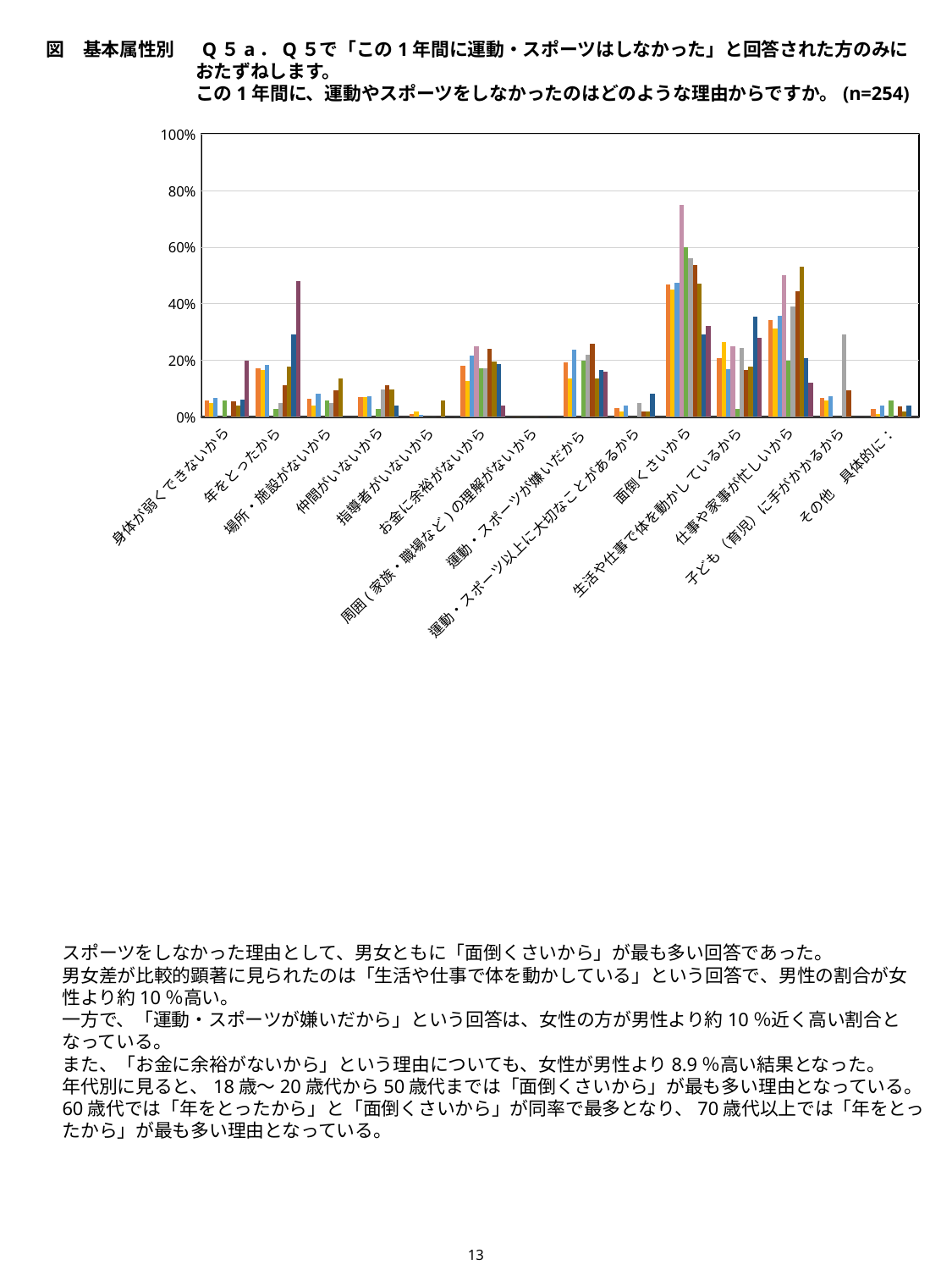
Is the tallest bar in the 面倒くさいから group greater or less than 60%? greater Which category shows no visible bars at all in the chart? 周囲（家族・職場など）の理解がないから Which category contains the tallest bar in the chart? 面倒くさいから What is the maximum value shown on the chart's vertical axis? 100% Is the tallest bar in the 指導者がいないから group greater or less than 20%? less How many reason categories are shown along the x axis of the chart? 14 Is the tallest bar in the 年をとったから group greater or less than 40%? greater Which group has taller bars overall: 面倒くさいから or 仲間がいないから? 面倒くさいから What kind of chart is shown on the slide? bar chart